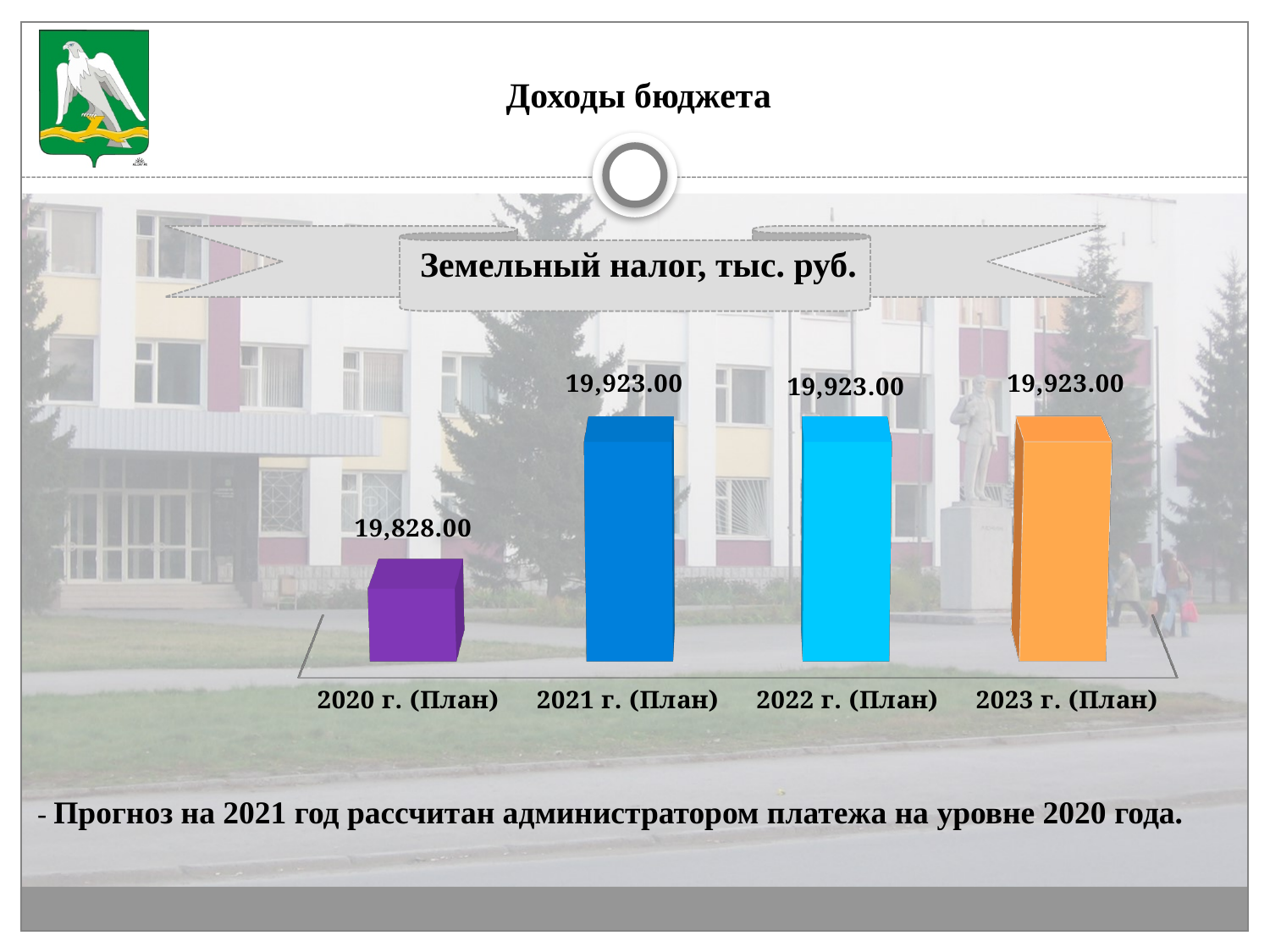
What is the value for 2022 г. (План) in the Земельный налог chart? 19,923.00 Which category has the lowest value in the Земельный налог chart? 2020 г. (План) What is the title of the chart on the slide? Земельный налог, тыс. руб. Are the values for 2021, 2022 and 2023 г. (План) the same or different? The same What is the value for 2020 г. (План) in the Земельный налог chart? 19,828.00 What is the value for 2021 г. (План) in the Земельный налог chart? 19,923.00 How many categories are shown in the Земельный налог chart? 4 What is the difference between the values for 2021 г. (План) and 2020 г. (План)? 95.00 What is the value for 2023 г. (План) in the Земельный налог chart? 19,923.00 What kind of chart is shown on the slide? Bar chart Which is larger, the value for 2020 г. (План) or the value for 2021 г. (План)? 2021 г. (План) Do the values rise or fall from 2020 г. (План) to 2021 г. (План)? Rise